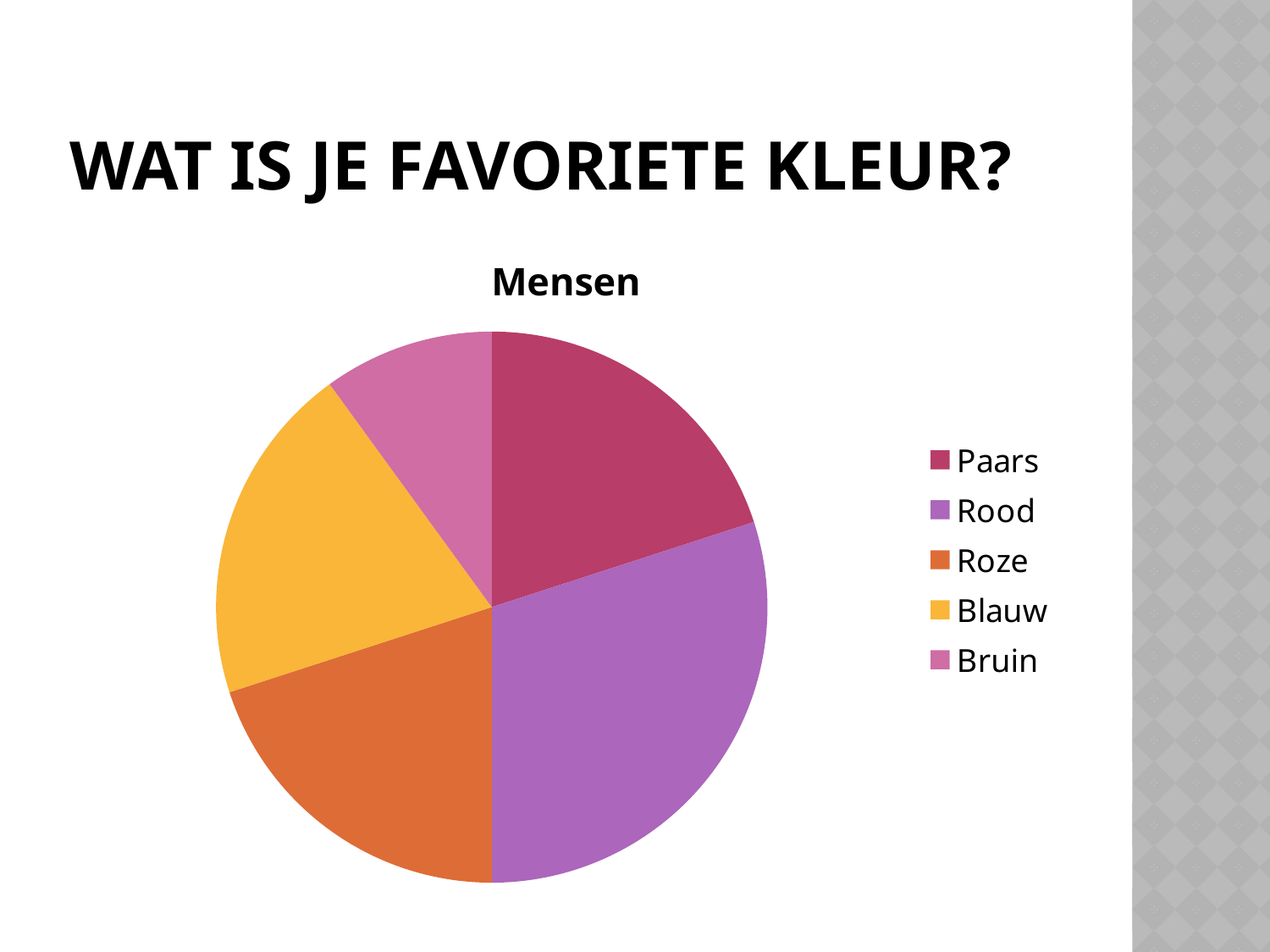
Which category has the largest slice of the pie? Rood Which slice is larger, Bruin or Blauw? Blauw Which slice is larger, Roze or Bruin? Roze What is the title of the chart? Mensen Which slice is larger, Rood or Paars? Rood Which category has the smallest slice of the pie? Bruin How many slices does the pie chart have? 5 Which category is shown in yellow in the pie chart? Blauw Which category is listed last in the legend? Bruin What kind of chart is shown on the slide? Pie chart